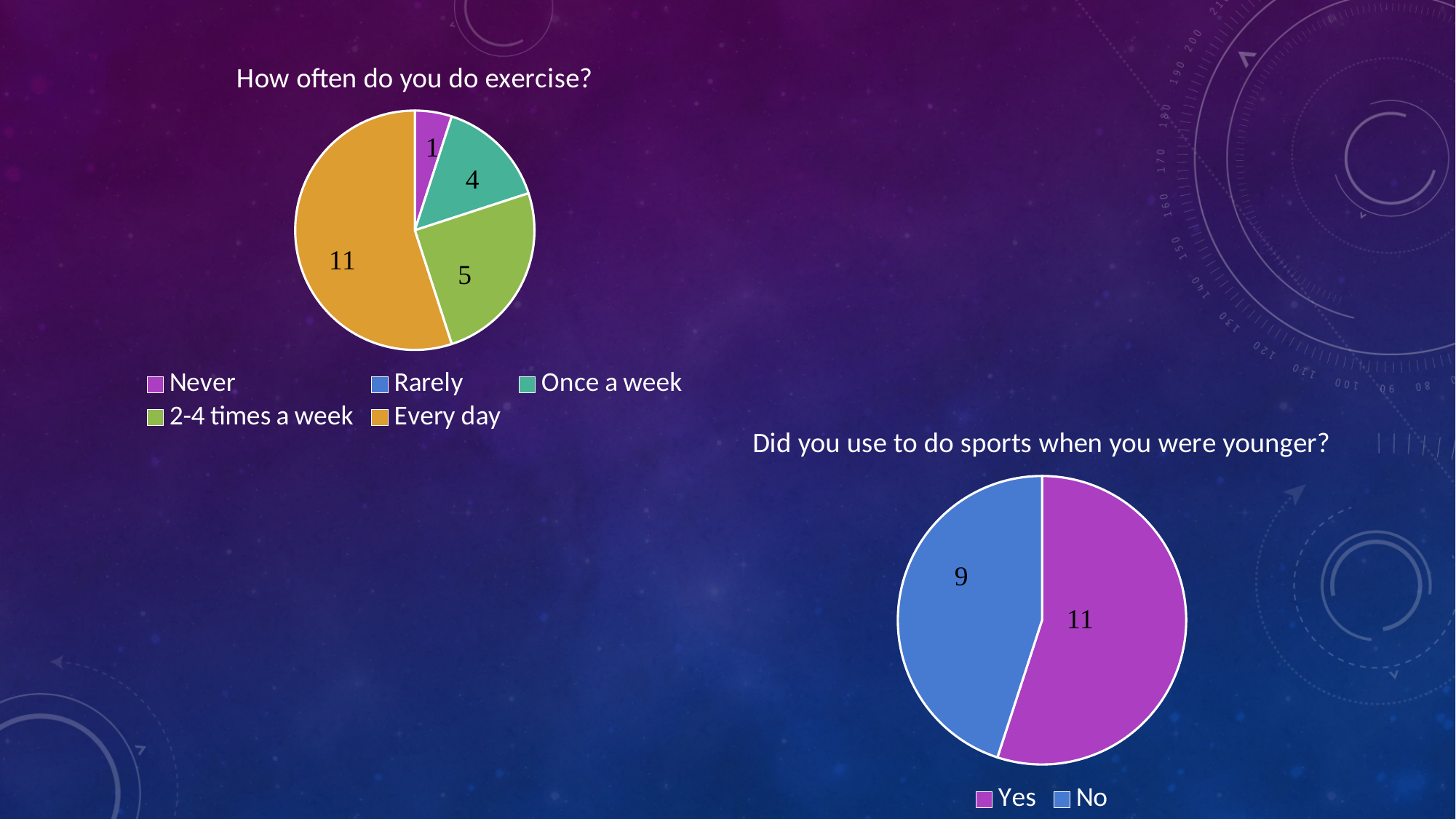
In the 'How often do you do exercise?' chart, which category has the largest slice? Every day In the 'How often do you do exercise?' chart, what is the difference between Every day and 2-4 times a week? 6 How many entries does the legend of the 'How often do you do exercise?' chart list? 5 What kind of chart is 'Did you use to do sports when you were younger?'? Pie chart In the 'Did you use to do sports when you were younger?' chart, what share of the pie is Yes? 55% In the 'How often do you do exercise?' chart, what is the value for 2-4 times a week? 5 In the 'Did you use to do sports when you were younger?' chart, what is the difference between Yes and No? 2 In the 'How often do you do exercise?' chart, which is larger, Once a week or Never? Once a week In the 'How often do you do exercise?' chart, what is the value for Once a week? 4 In the 'Did you use to do sports when you were younger?' chart, what is the value for Yes? 11 In the 'How often do you do exercise?' chart, what is the value for Every day? 11 In the 'Did you use to do sports when you were younger?' chart, what colour is the No slice? Blue